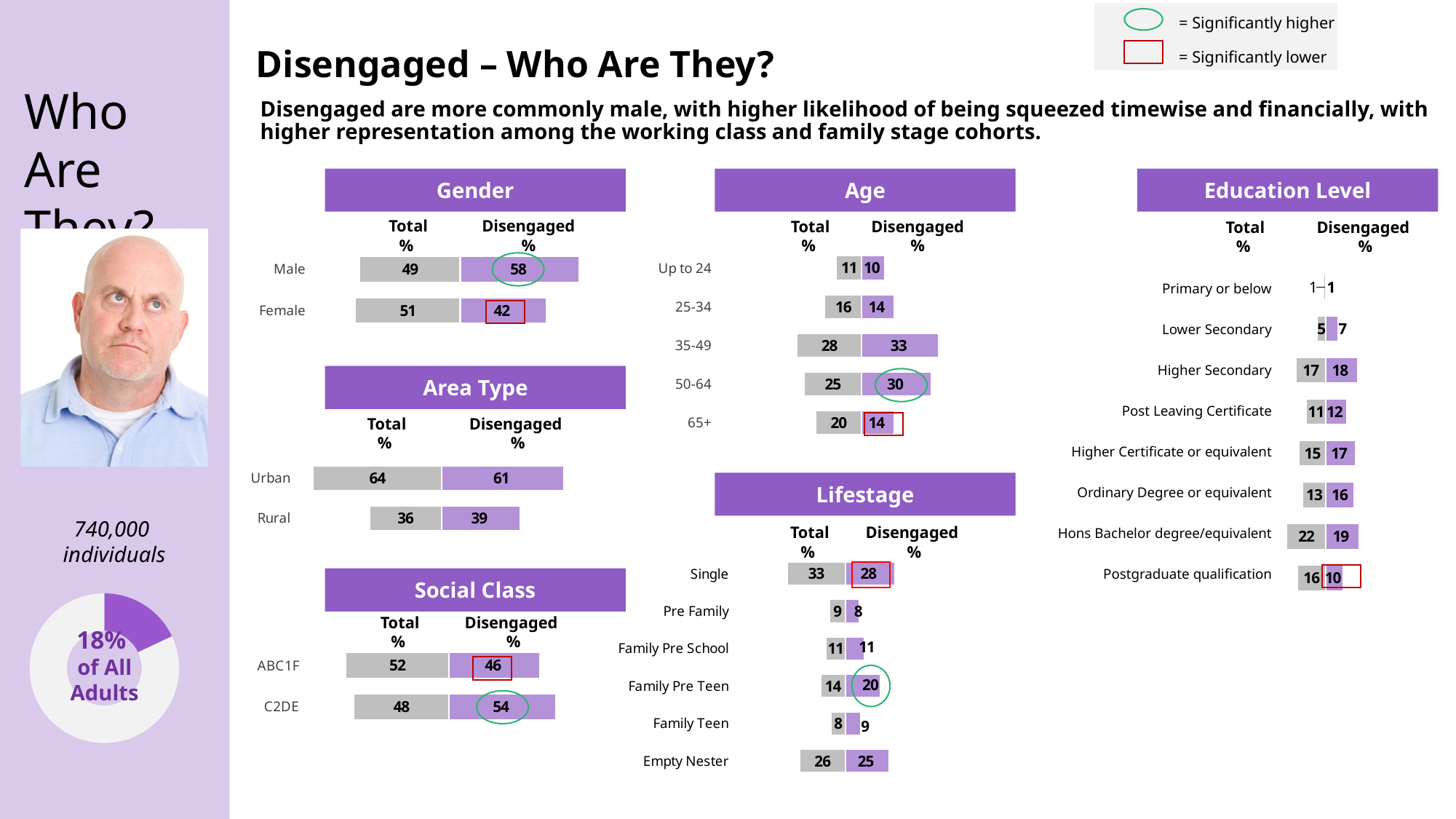
In the Education Level chart, what is the Disengaged % for Postgraduate qualification? 10 What share of all adults does the donut chart on the left show as Disengaged? 18% In the Area Type chart, what is the Disengaged % for Rural? 39 In the Age chart, which age group has the highest Disengaged %? 35-49 In the Lifestage chart, what is the Disengaged % for Family Pre Teen? 20 In the Social Class chart, which category has the higher Disengaged %? C2DE In the Gender chart, what is the Disengaged % for Male? 58 In the Lifestage chart, which lifestage has the lowest Disengaged %? Pre Family In the Age chart, what is the Disengaged % for 65+? 14 How many age groups are shown in the Age chart? 5 In the Education Level chart, is the Total % or the Disengaged % larger for Hons Bachelor degree/equivalent? Total % In the Gender chart, what is the difference between the Total % and Disengaged % for Female? 9